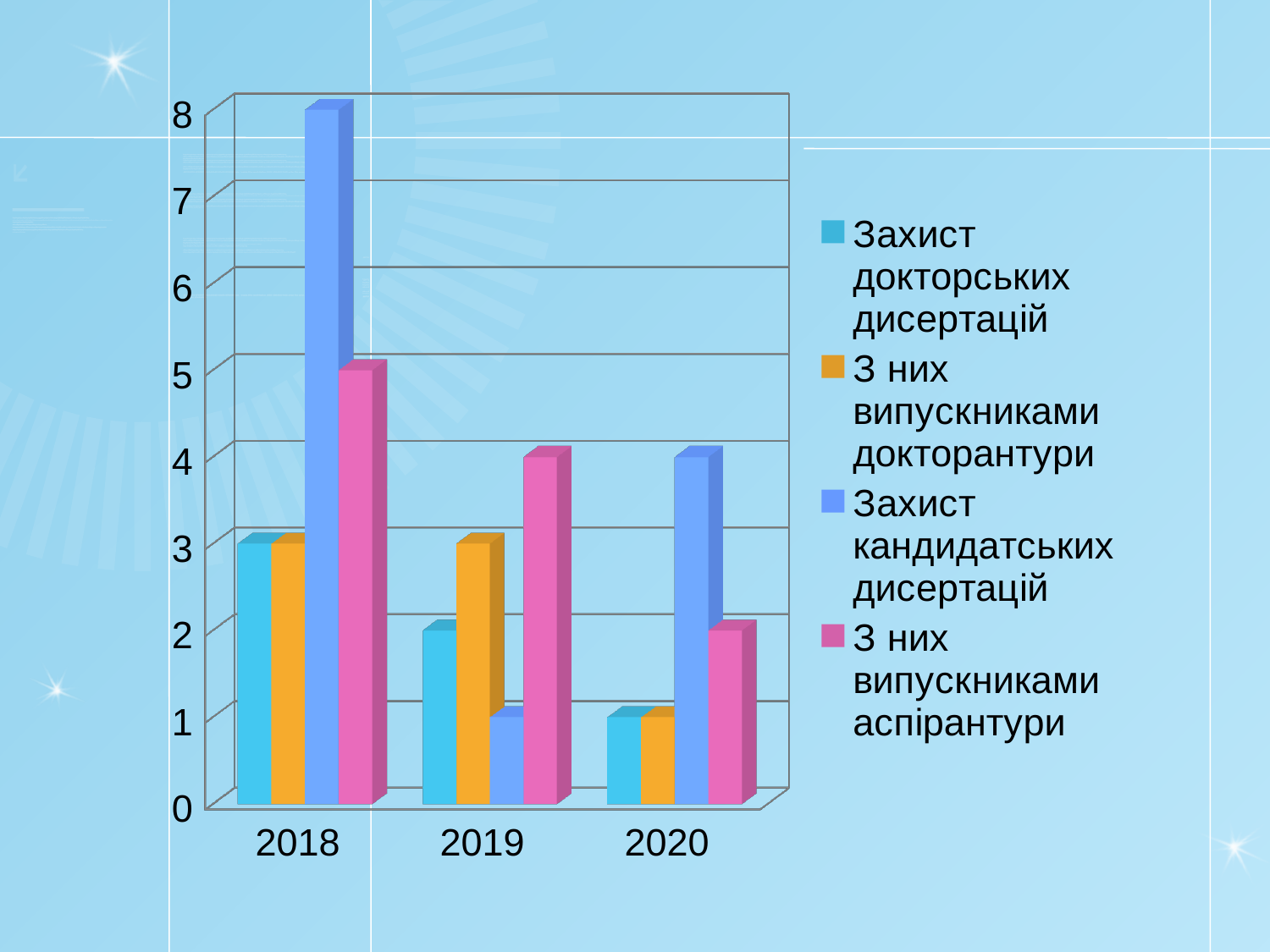
Which colour represents "З них випускниками докторантури" in the legend? orange What is the value for "Захист кандидатських дисертацій" in 2018? 8 In which year is the value for "Захист докторських дисертацій" highest? 2018 What is the difference between "Захист кандидатських дисертацій" in 2018 and in 2020? 4 Which is larger in 2019: "З них випускниками докторантури" or "З них випускниками аспірантури"? З них випускниками аспірантури What is the value for "Захист докторських дисертацій" in 2019? 2 In which year is the value for "Захист кандидатських дисертацій" lowest? 2019 How many years are shown on the x axis? 3 What kind of chart is shown on the slide? bar chart How many series does the legend list? 4 What is the value for "З них випускниками аспірантури" in 2020? 2 Does the value for "Захист докторських дисертацій" rise or fall from 2018 to 2020? fall